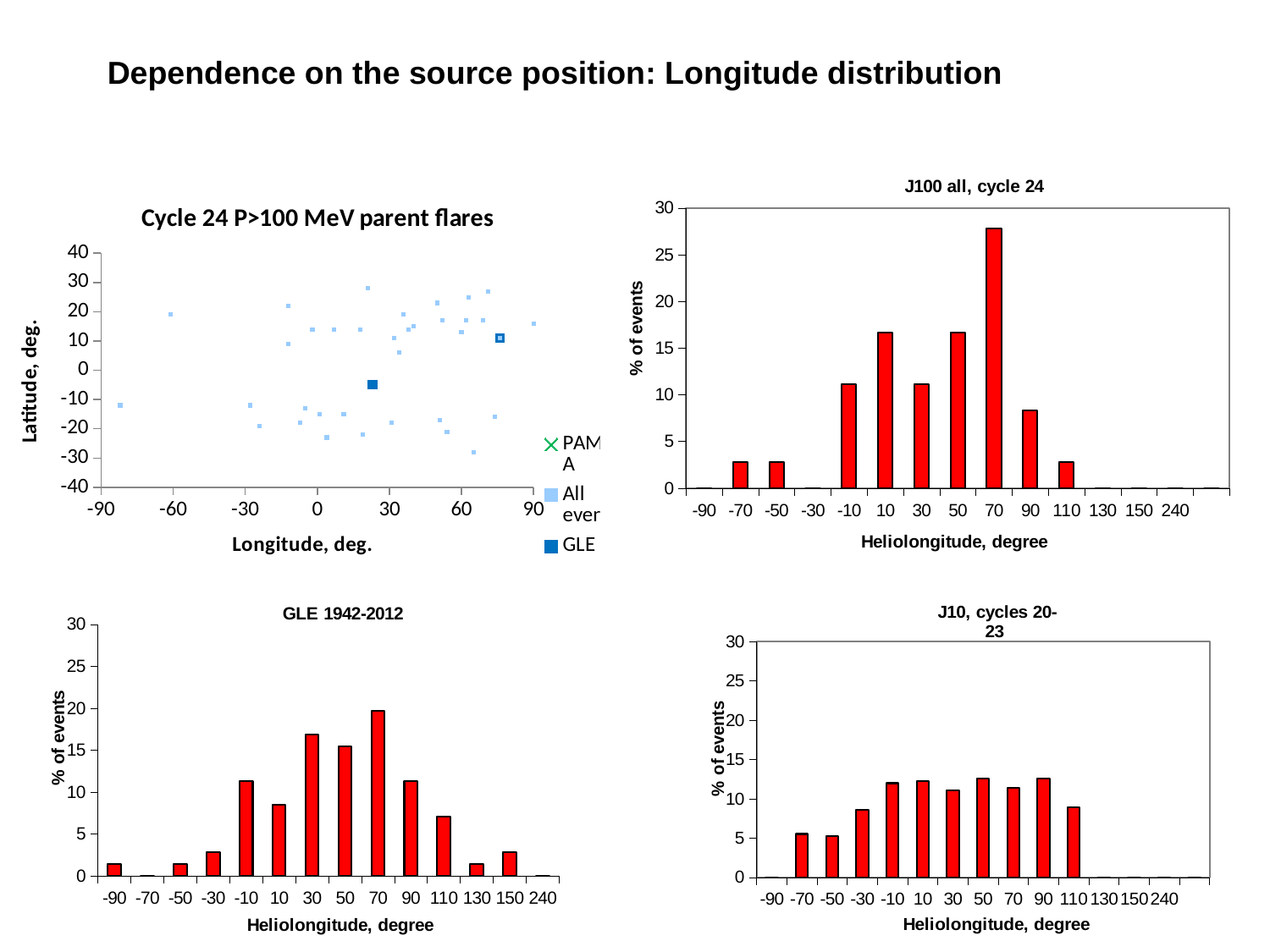
In the 'J100 all, cycle 24' chart, is the value for the 70 degree bin greater or less than 25? greater In the 'GLE 1942-2012' chart, which heliolongitude bin has the highest percentage of events? 70 In the 'GLE 1942-2012' chart, which is larger, the value at 30 degrees or the value at 10 degrees? 30 degrees In the 'GLE 1942-2012' chart, is the value for the 70 degree bin greater or less than 15? greater In the 'GLE 1942-2012' chart, is the value for the 110 degree bin greater or less than 10? less In the 'J100 all, cycle 24' chart, which heliolongitude bin has the highest percentage of events? 70 In the 'J100 all, cycle 24' chart, which is larger, the value at 70 degrees or the value at 10 degrees? 70 degrees How many series does the legend of the 'Cycle 24 P>100 MeV parent flares' chart list? 3 What kind of chart is 'Cycle 24 P>100 MeV parent flares' (top left)? scatter chart